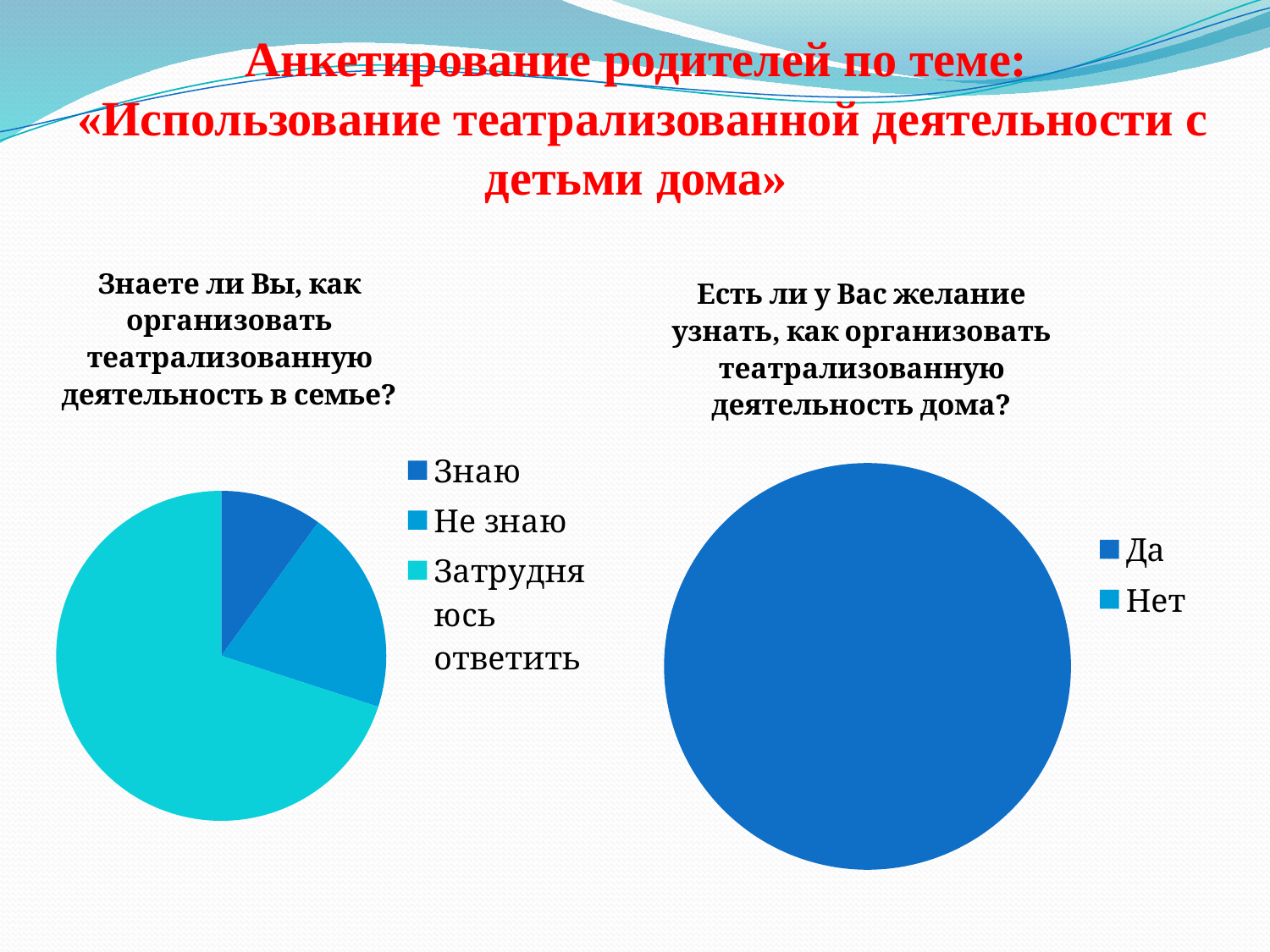
How many entries does the legend of the right chart list? 2 What kind of chart is the left chart titled «Знаете ли Вы, как организовать театрализованную деятельность в семье?»? pie chart In the right chart, which slice is larger: «Да» or «Нет»? Да In the left chart, which category has the smallest slice? Знаю In the left chart, which category has the largest slice? Затрудняюсь ответить In the right chart, which category has the largest slice? Да In the left chart, which slice is larger: «Не знаю» or «Затрудняюсь ответить»? Затрудняюсь ответить In the left chart, which slice is larger: «Знаю» or «Не знаю»? Не знаю How many charts are shown on the slide? 2 What are the legend entries of the right chart? Да, Нет How many entries does the legend of the left chart list? 3 What kind of chart is the right chart titled «Есть ли у Вас желание узнать, как организовать театрализованную деятельность дома?»? pie chart